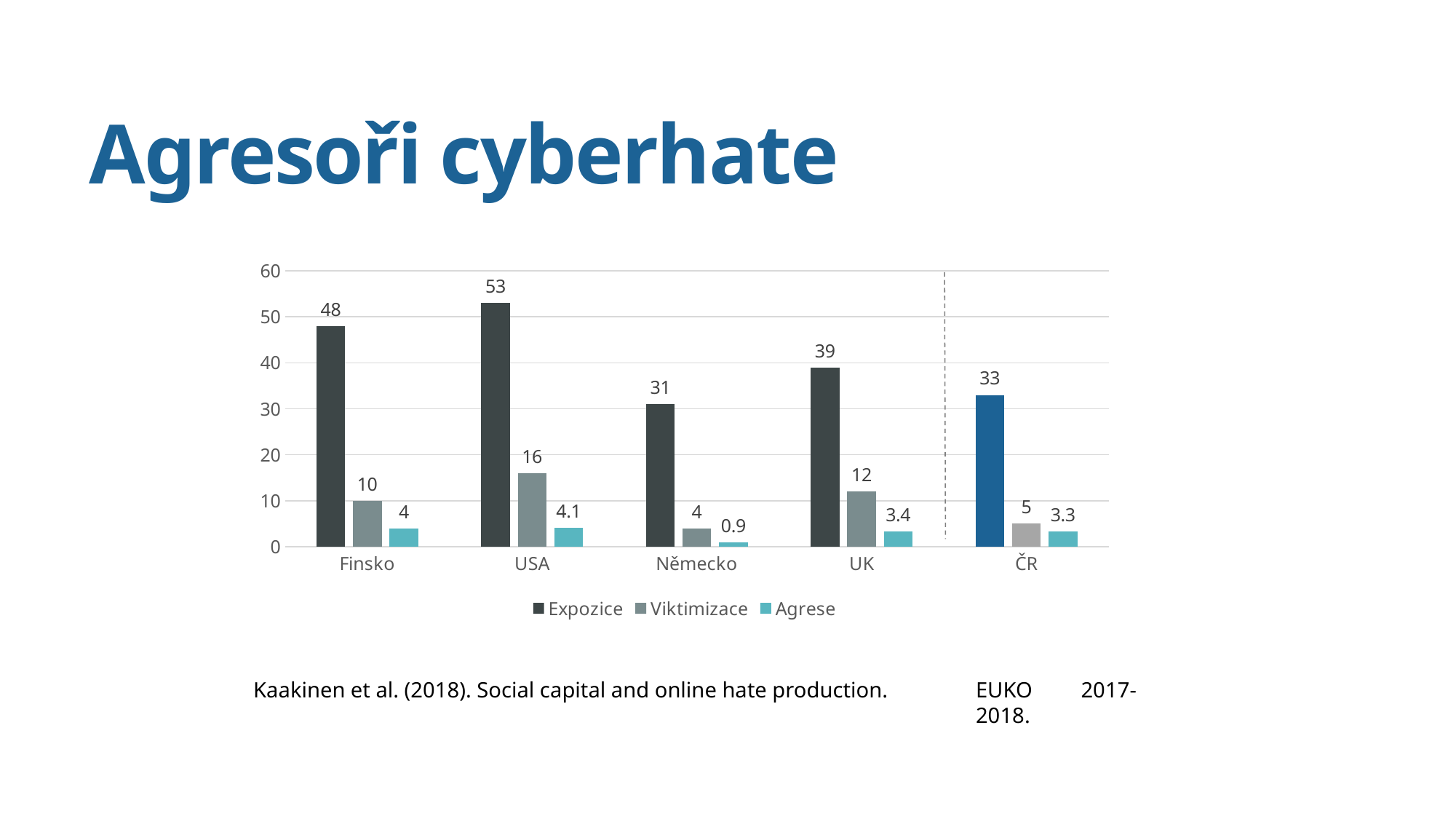
What are the three series named in the legend? Expozice, Viktimizace, Agrese Which country has the highest Expozice value? USA What is the Agrese value for ČR? 3.3 Which country has the lowest Agrese value? Německo What is the Expozice value for USA? 53 What is the Viktimizace value for UK? 12 How many series does the legend list? 3 What is the difference between the Expozice values for USA and Finsko? 5 Which is larger, the Viktimizace value for Finsko or for UK? UK What kind of chart is shown on the slide? Bar chart How many countries are shown on the x axis? 5 What is the Agrese value for Německo? 0.9